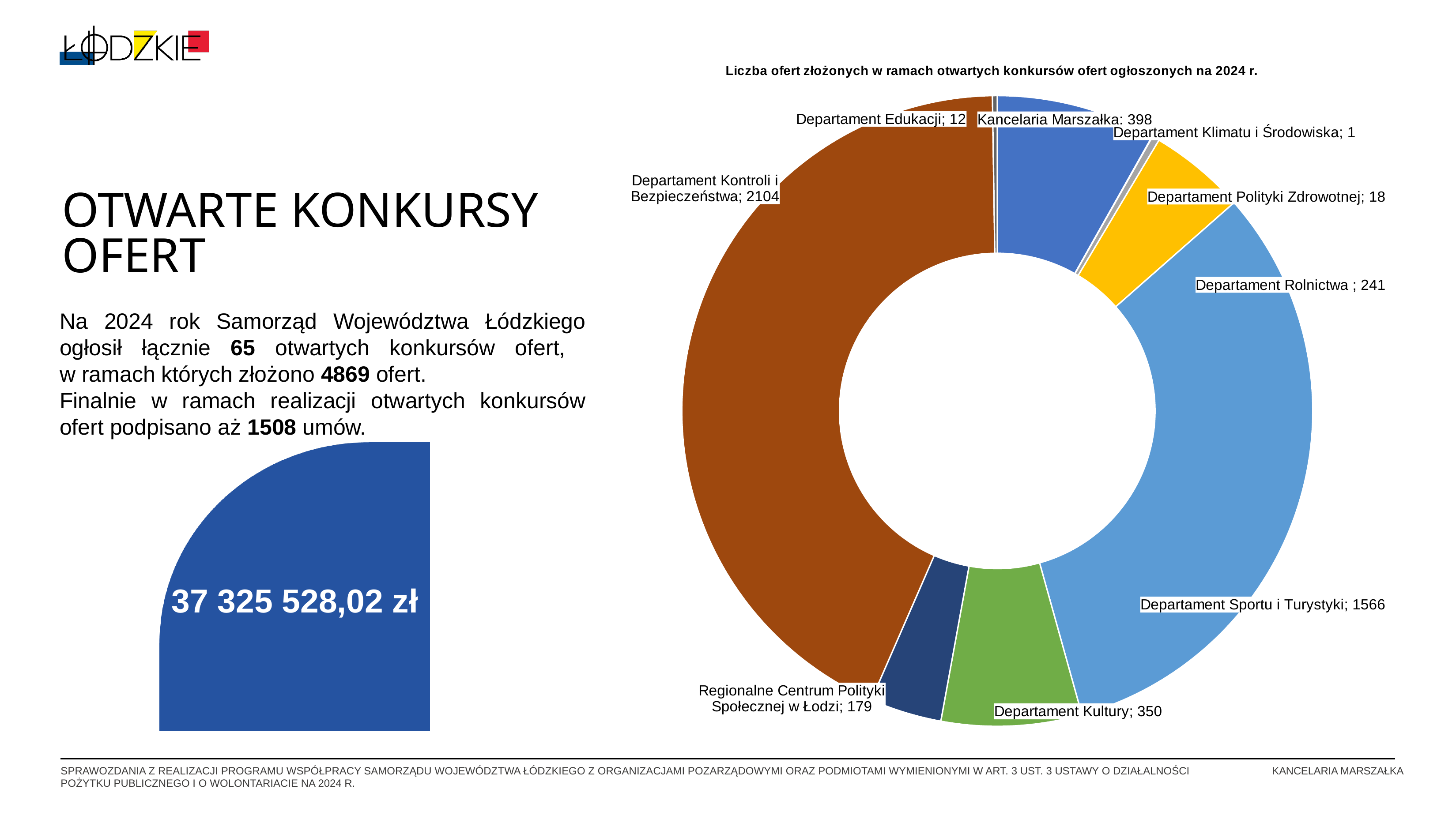
What is the difference between the values for Departament Kontroli i Bezpieczeństwa and Departament Sportu i Turystyki? 538 Which department has the smallest number of offers in the chart? Departament Klimatu i Środowiska What kind of chart is shown on the right of the slide? doughnut (pie) chart What is the value shown for Regionalne Centrum Polityki Społecznej w Łodzi? 179 What is the difference between the values for Departament Polityki Zdrowotnej and Departament Edukacji? 6 What is the value shown for Kancelaria Marszałka? 398 What is the title of the chart on the slide? Liczba ofert złożonych w ramach otwartych konkursów ofert ogłoszonych na 2024 r. Which has more offers: Departament Kultury or Departament Rolnictwa? Departament Kultury What is the value shown for Departament Sportu i Turystyki? 1566 Which department has the largest number of offers in the chart? Departament Kontroli i Bezpieczeństwa How many categories (departments) are shown in the chart? 9 How many offers were submitted for Departament Kontroli i Bezpieczeństwa? 2104